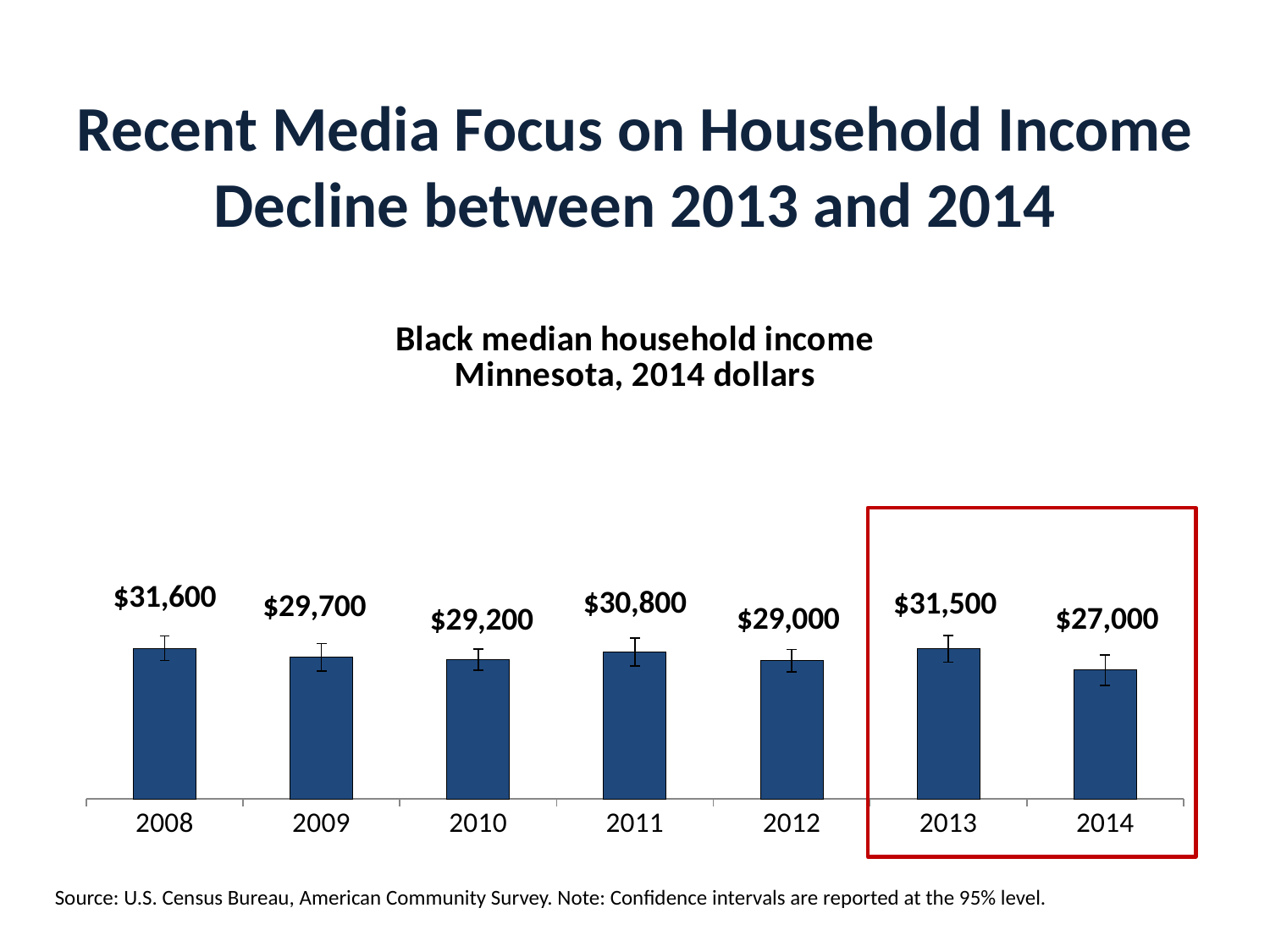
Which is larger, the value for 2009 or the value for 2010? 2009 What kind of chart is shown on the slide? Bar chart Which year has the lowest Black median household income? 2014 Does the value rise or fall from 2013 to 2014? Fall What is the Black median household income in Minnesota for 2008? $31,600 What is the title of the chart? Black median household income Minnesota, 2014 dollars What is the Black median household income in Minnesota for 2014? $27,000 What is the difference between the 2008 and 2012 values? $2,600 Which year has the highest Black median household income? 2008 What is the difference between the 2013 and 2014 values? $4,500 What is the value shown for 2011? $30,800 How many years are shown on the chart? 7